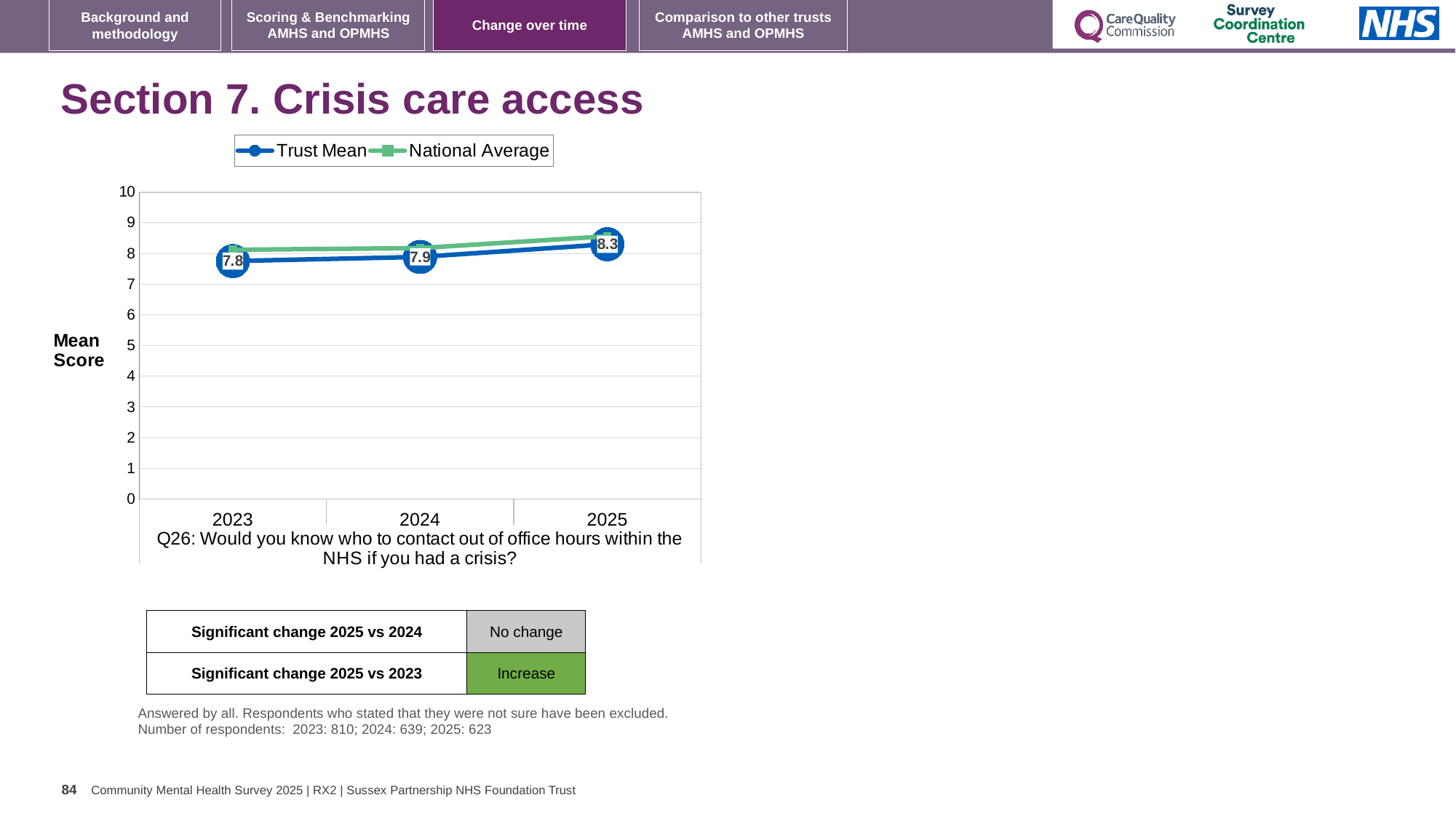
How many series does the chart legend list? 2 In which year is the Trust Mean highest? 2025 What is the difference between the Trust Mean in 2025 and in 2023? 0.5 Which is larger, the Trust Mean in 2024 or in 2025? 2025 Is the National Average value for 2023 greater or less than 7? greater What is the Trust Mean score for 2025? 8.3 What kind of chart is shown on the slide? Line chart In which year is the Trust Mean lowest? 2023 What is the Trust Mean score for 2024? 7.9 How many years are shown on the x axis of the chart? 3 What is the Trust Mean score for 2023? 7.8 Is the National Average value for 2025 greater or less than 9? less